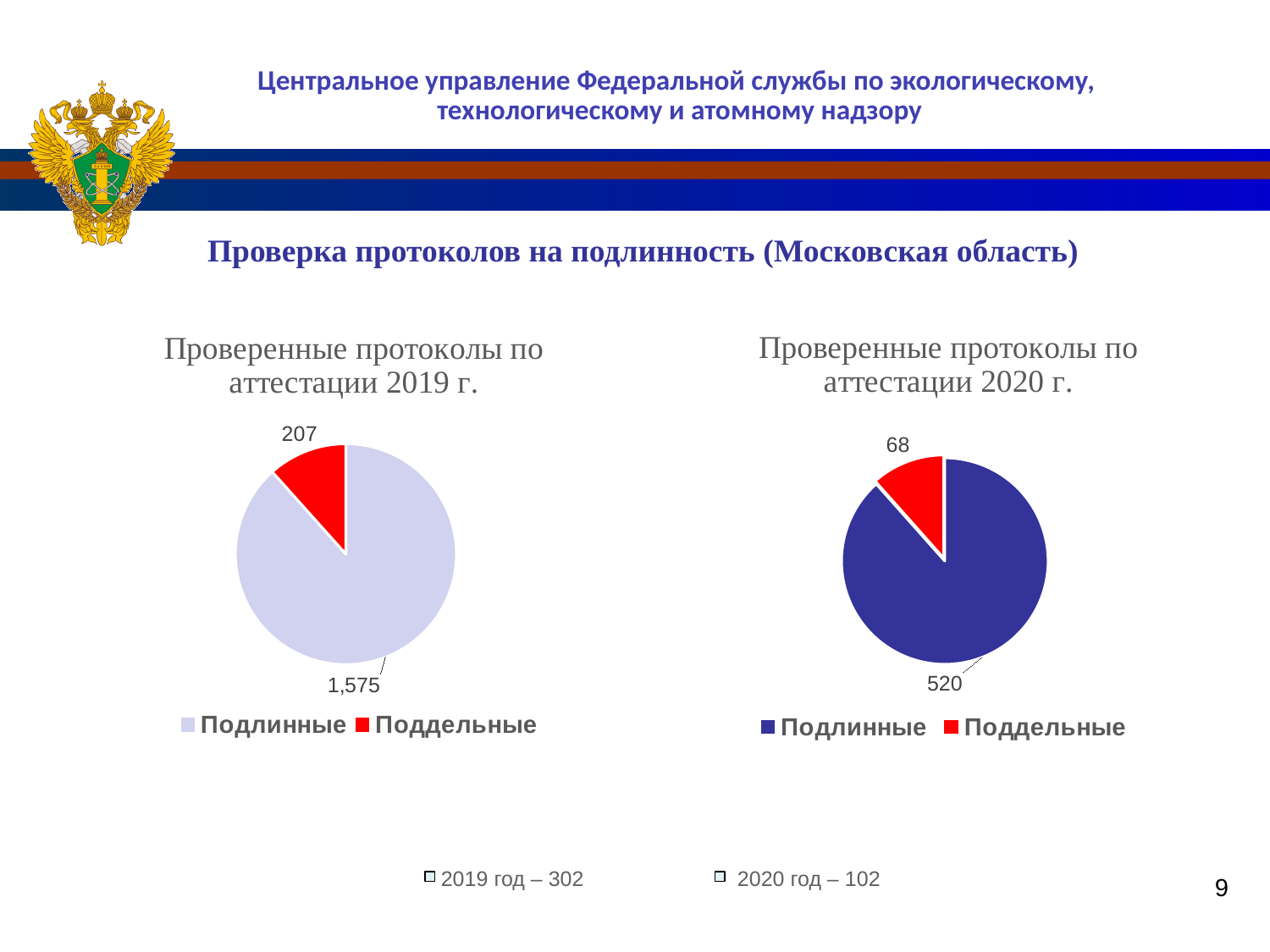
In the chart 'Проверенные протоколы по аттестации 2019 г.', what is the difference between Подлинные and Поддельные? 1,368 In the chart 'Проверенные протоколы по аттестации 2020 г.', what is the value for Поддельные? 68 In the chart 'Проверенные протоколы по аттестации 2019 г.', which category has the largest slice? Подлинные In the chart 'Проверенные протоколы по аттестации 2020 г.', what is the difference between Подлинные and Поддельные? 452 In the chart 'Проверенные протоколы по аттестации 2019 г.', what is the value for Подлинные? 1,575 What colour is the Поддельные slice in the chart 'Проверенные протоколы по аттестации 2020 г.'? Red Is the value for Поддельные larger in the 2019 chart or in the 2020 chart? 2019 How many categories does the legend of the chart 'Проверенные протоколы по аттестации 2019 г.' list? 2 In the chart 'Проверенные протоколы по аттестации 2020 г.', what is the value for Подлинные? 520 In the chart 'Проверенные протоколы по аттестации 2019 г.', what is the value for Поддельные? 207 What type of chart is 'Проверенные протоколы по аттестации 2020 г.'? Pie chart In the chart 'Проверенные протоколы по аттестации 2020 г.', which category has the smallest slice? Поддельные